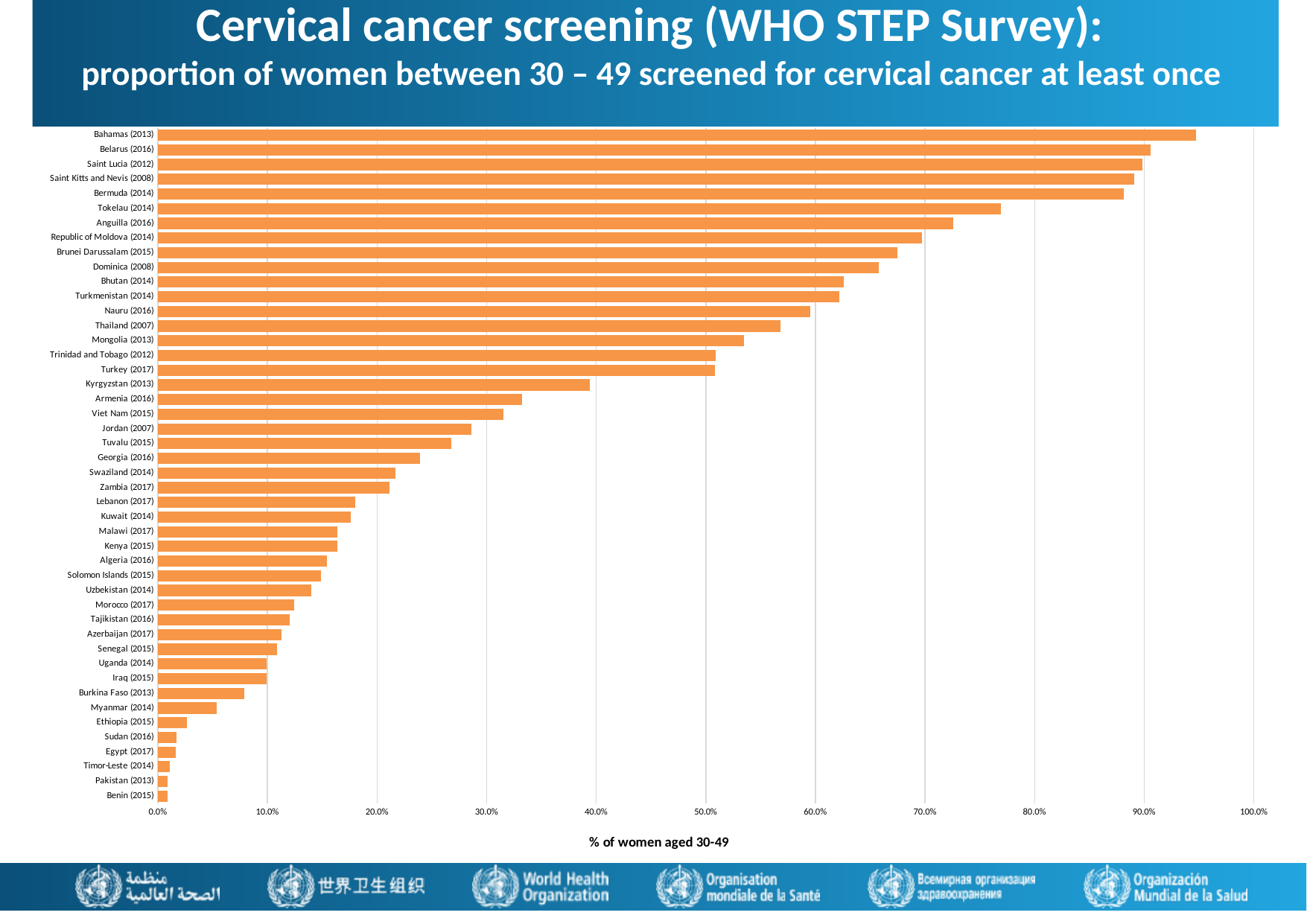
Is the value for Georgia (2016) greater or less than 20%? greater What is the label on the horizontal axis of the chart? % of women aged 30-49 What kind of chart is shown on the slide? bar chart Is the value for Thailand (2007) greater or less than 50%? greater Which country has the highest proportion of women screened for cervical cancer? Bahamas (2013) Which has a higher value, Tokelau (2014) or Anguilla (2016)? Tokelau (2014) Is the value for Tokelau (2014) greater or less than 70%? greater Which has a higher value, Kyrgyzstan (2013) or Armenia (2016)? Kyrgyzstan (2013) Do the bar values rise or fall going from the top of the chart to the bottom? fall How many countries are listed in the chart? 46